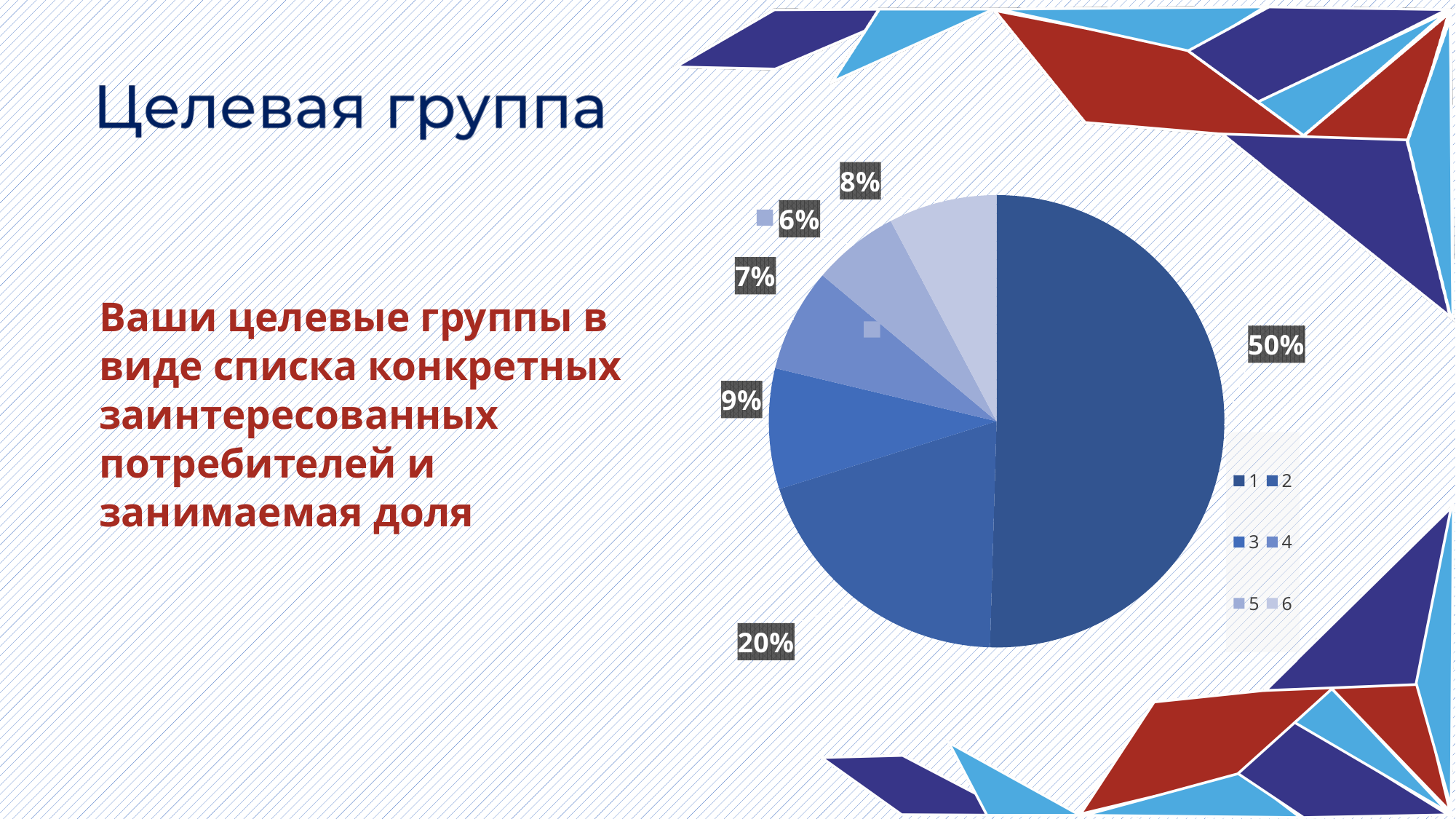
What share of the pie does category 1 have? 50% Which is larger, the share of category 3 or the share of category 4? category 3 What is the title of the slide containing the pie chart? Целевая группа What share of the pie does category 6 have? 8% Which category has the smallest slice of the pie? 5 What type of chart is shown on the slide? pie chart Which category has the largest slice of the pie? 1 What is the difference between the shares of category 1 and category 2? 30% What share of the pie does category 3 have? 9% What share of the pie does category 2 have? 20% How many entries does the legend list? 6 How many slices does the pie chart have? 6